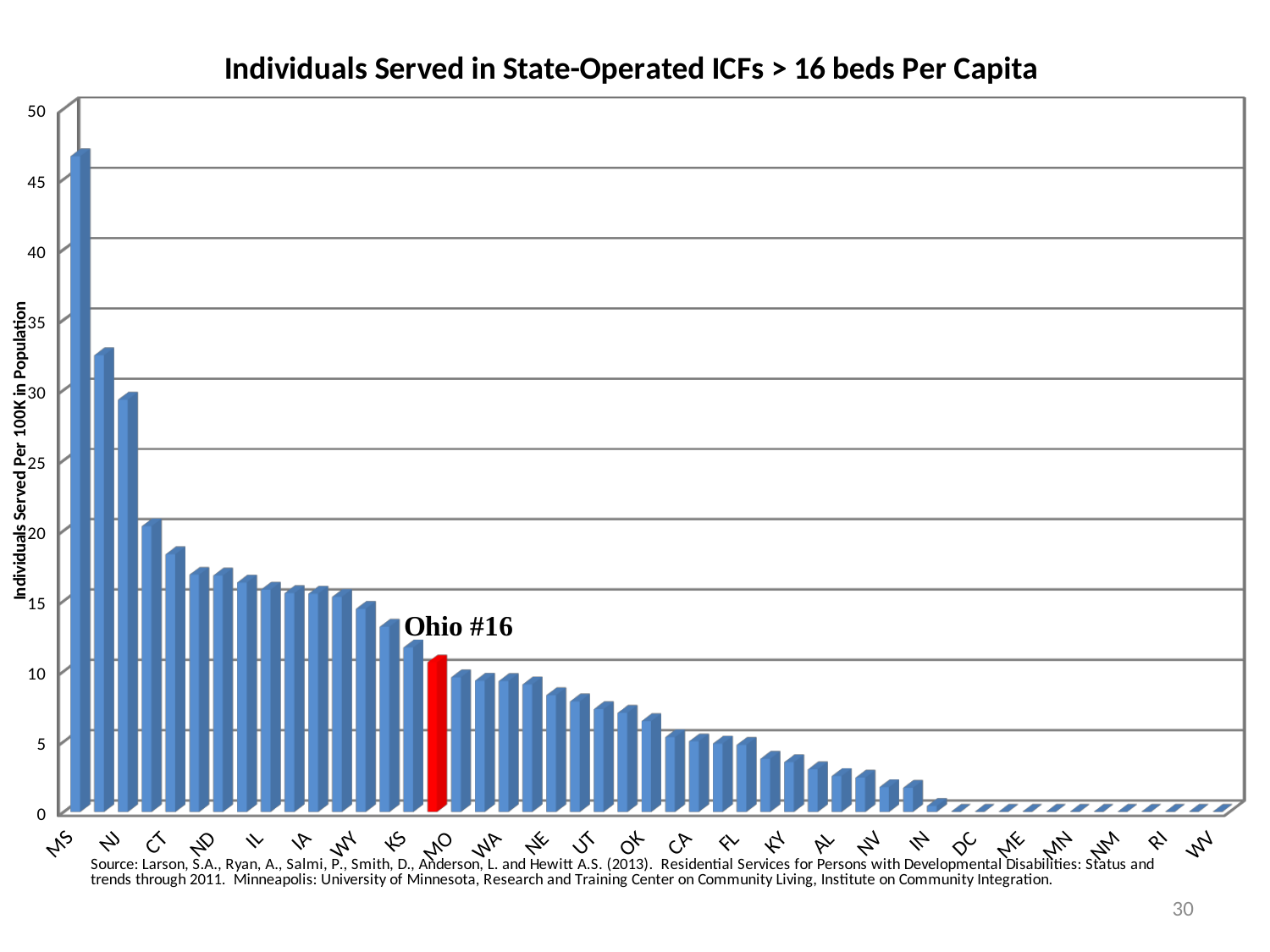
Do the values rise or fall moving from left to right along the x axis? fall Is the value for IL greater or less than 20? less Which state has the highest value for individuals served in state-operated ICFs > 16 beds per capita? MS Which has a larger value, MS or NJ? MS Is the value for UT greater or less than 10? less Is the value for MS greater or less than 45? greater What rank does the annotation give Ohio in this chart? #16 What kind of chart is shown on the slide? bar chart